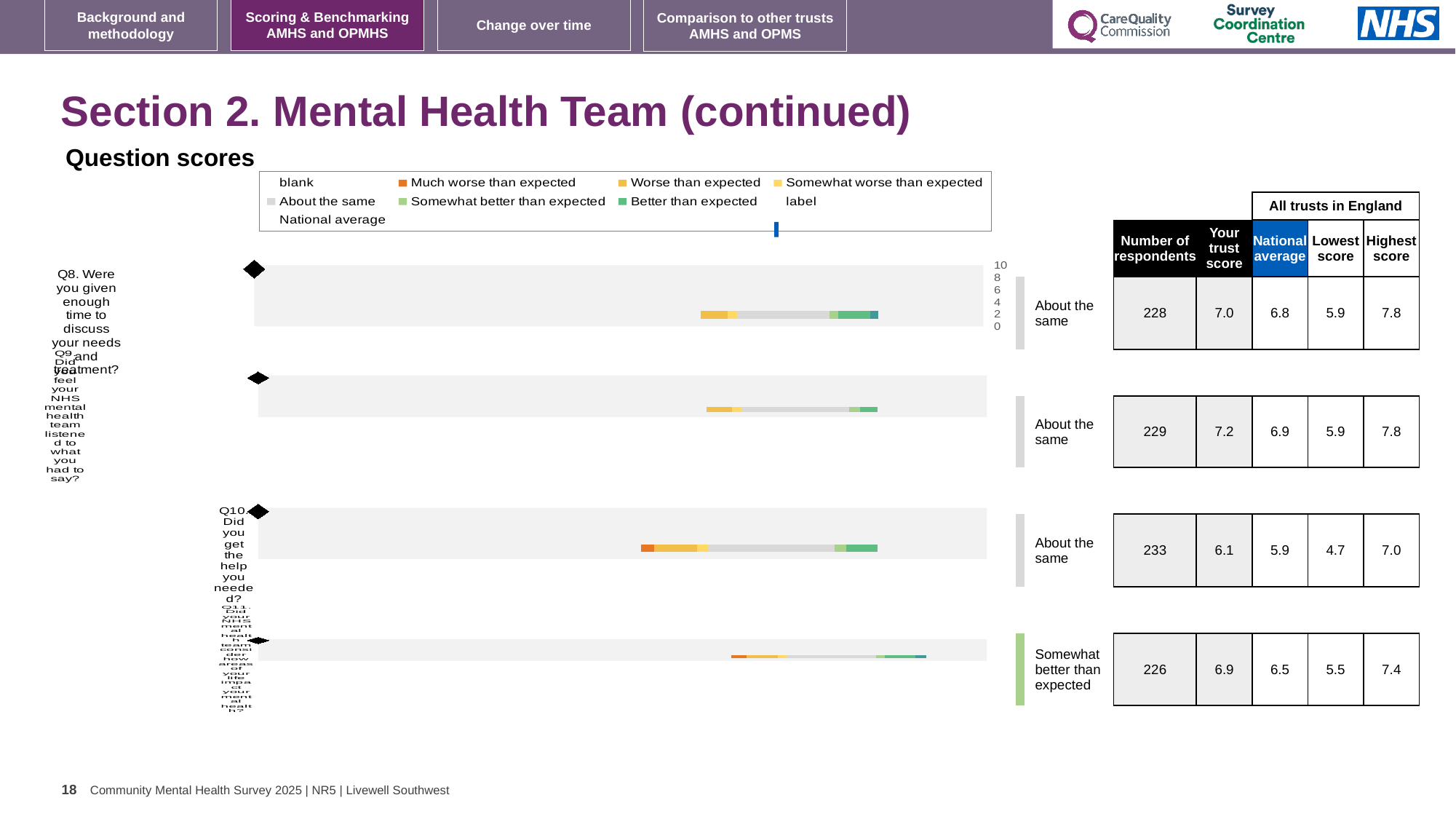
In the table beside the charts, which row is labelled 'Somewhat better than expected' rather than 'About the same'? the fourth row (Q11) In the table beside the charts, what is the highest score for the fourth row (Q11)? 7.4 What is the heading printed above the 'National average', 'Lowest score' and 'Highest score' columns in the table beside the charts? All trusts in England How many separate question-score bar charts are shown on the slide? 4 In the table beside the charts, what is the difference between 'Your trust score' and the national average for the second row (Q9)? 0.3 In the table beside the charts, what is 'Your trust score' for the first row (Q8)? 7.0 In the table beside the charts, what is the national average for the third row (Q10)? 5.9 In the table beside the charts, which row has the lowest 'Your trust score'? Q10 (third row), 6.1 How many entries does the shared legend above the question-score charts list? 9 Which legend entry is shown in orange in the question-score charts' legend? Much worse than expected What kind of chart is used for the question scores on this slide? bar chart In the table beside the charts, what is the number of respondents for the first row (Q8)? 228